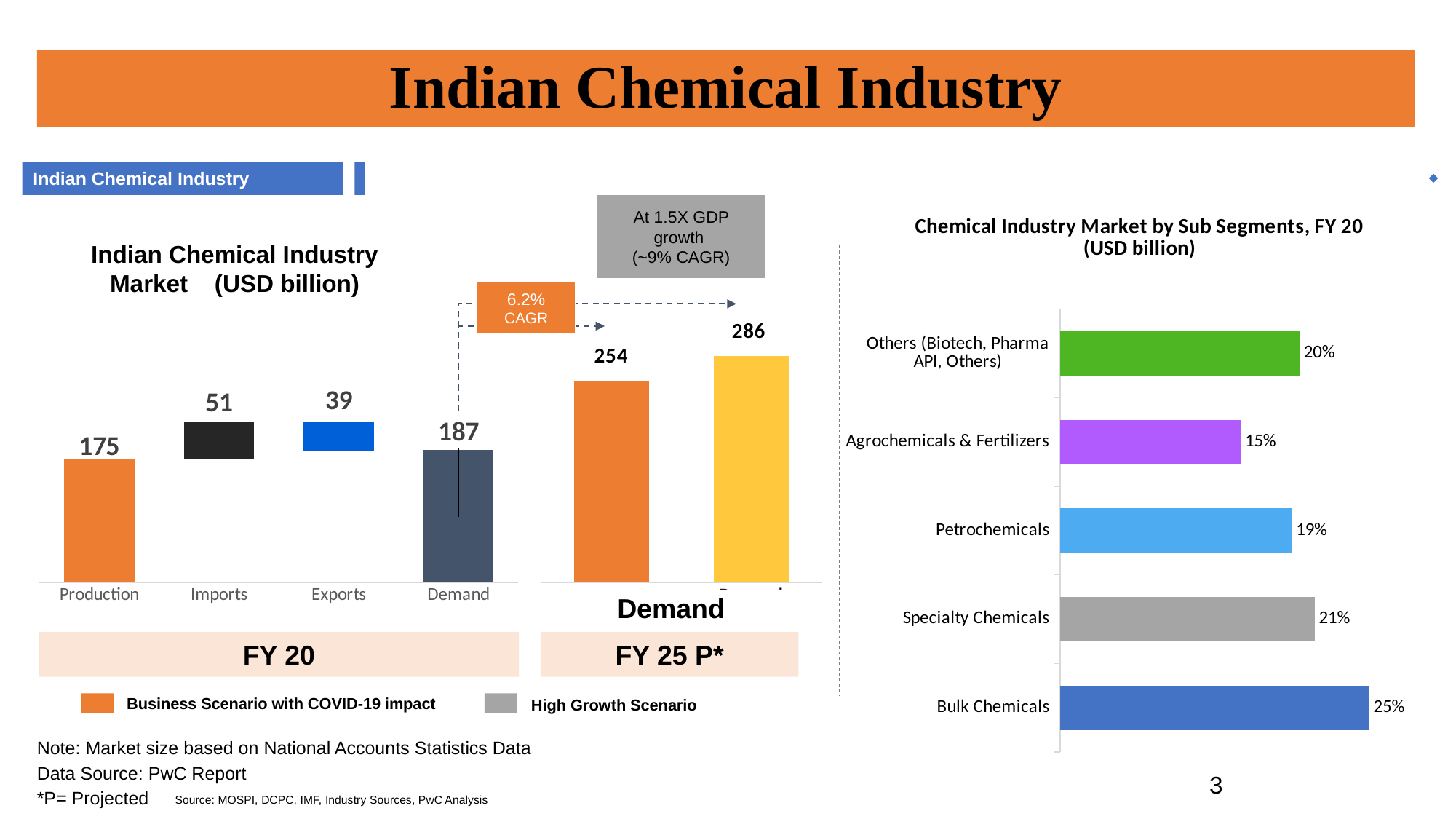
In the 'Indian Chemical Industry Market (USD billion)' chart, what is the value for Exports in FY 20? 39 How many sub segments are shown in the 'Chemical Industry Market by Sub Segments, FY 20 (USD billion)' chart? 5 In the 'Indian Chemical Industry Market (USD billion)' chart, what is the difference between the FY 25 P* Demand under the High Growth Scenario and under the Business Scenario with COVID-19 impact? 32 In the 'Indian Chemical Industry Market (USD billion)' chart, what CAGR is shown in the orange box between FY 20 Demand and FY 25 P* Demand? 6.2% CAGR In the 'Indian Chemical Industry Market (USD billion)' chart, what is the value for Imports in FY 20? 51 In the 'Indian Chemical Industry Market (USD billion)' chart, what is the value for Production in FY 20? 175 In the 'Indian Chemical Industry Market (USD billion)' chart, which is larger in FY 20: Imports or Exports? Imports In the 'Chemical Industry Market by Sub Segments, FY 20 (USD billion)' chart, which sub segment has the lowest share? Agrochemicals & Fertilizers In the 'Chemical Industry Market by Sub Segments, FY 20 (USD billion)' chart, which sub segment has the highest share? Bulk Chemicals In the 'Indian Chemical Industry Market (USD billion)' chart, what is the value for Demand in FY 20? 187 In the 'Indian Chemical Industry Market (USD billion)' chart, what is the projected FY 25 Demand under the High Growth Scenario? 286 In the 'Chemical Industry Market by Sub Segments, FY 20 (USD billion)' chart, what is the value for Petrochemicals? 19%